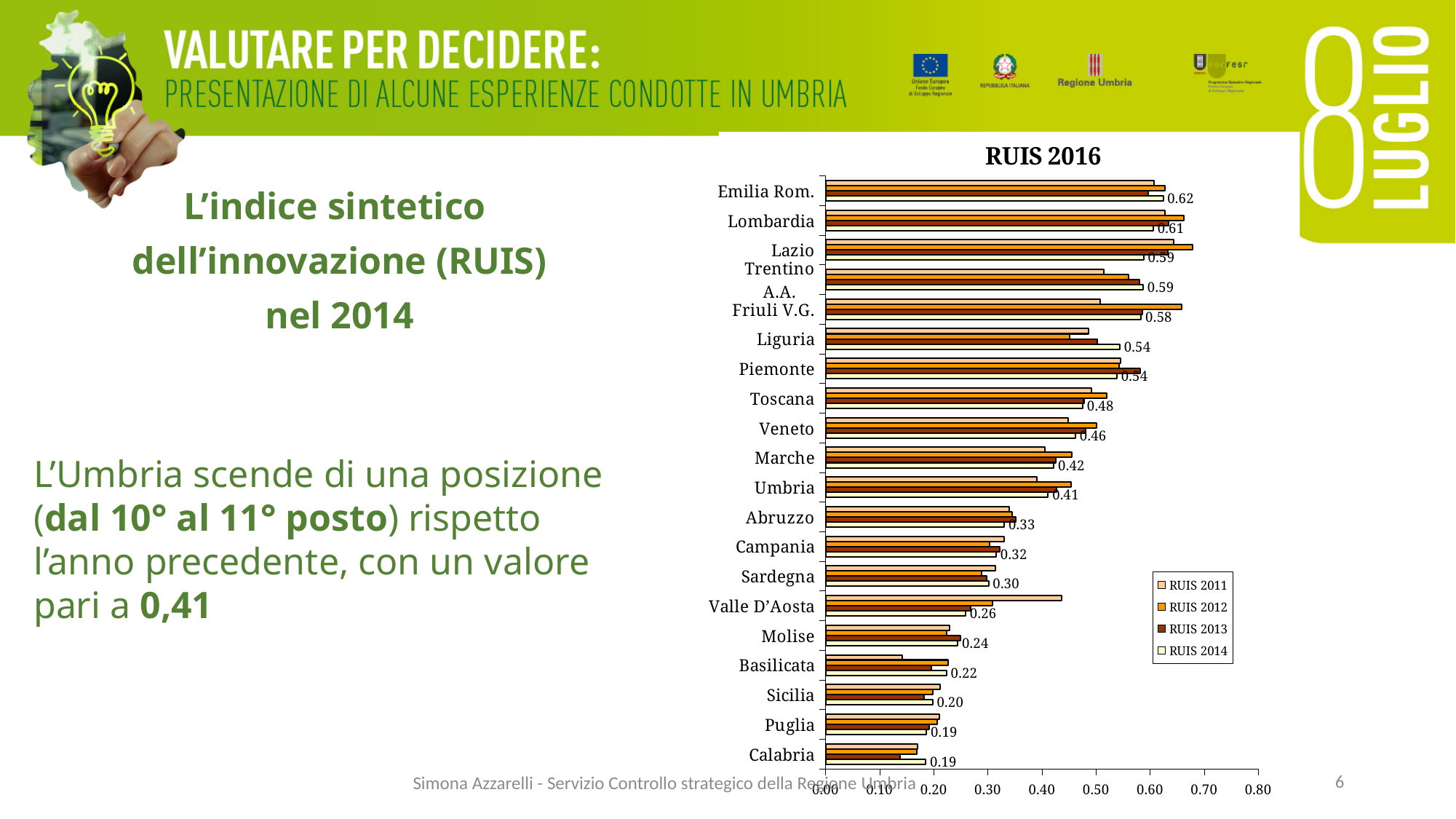
What is the title of the chart? RUIS 2016 Which has a larger RUIS 2014 value, Toscana or Veneto? Toscana Is the RUIS 2011 value for Valle D'Aosta greater or less than 0.40? greater What type of chart is shown on the slide? bar chart How many regions are shown on the chart? 20 What is the RUIS 2014 value for Valle D'Aosta? 0.26 Which region has the highest RUIS 2014 value? Emilia Rom. What is the RUIS 2014 value for Umbria? 0.41 What is the difference between the RUIS 2014 values of Emilia Rom. and Umbria? 0.21 How many series does the chart legend list? 4 What is the RUIS 2014 value for Emilia Rom.? 0.62 Is the RUIS 2014 value for Sardegna greater or less than 0.40? less